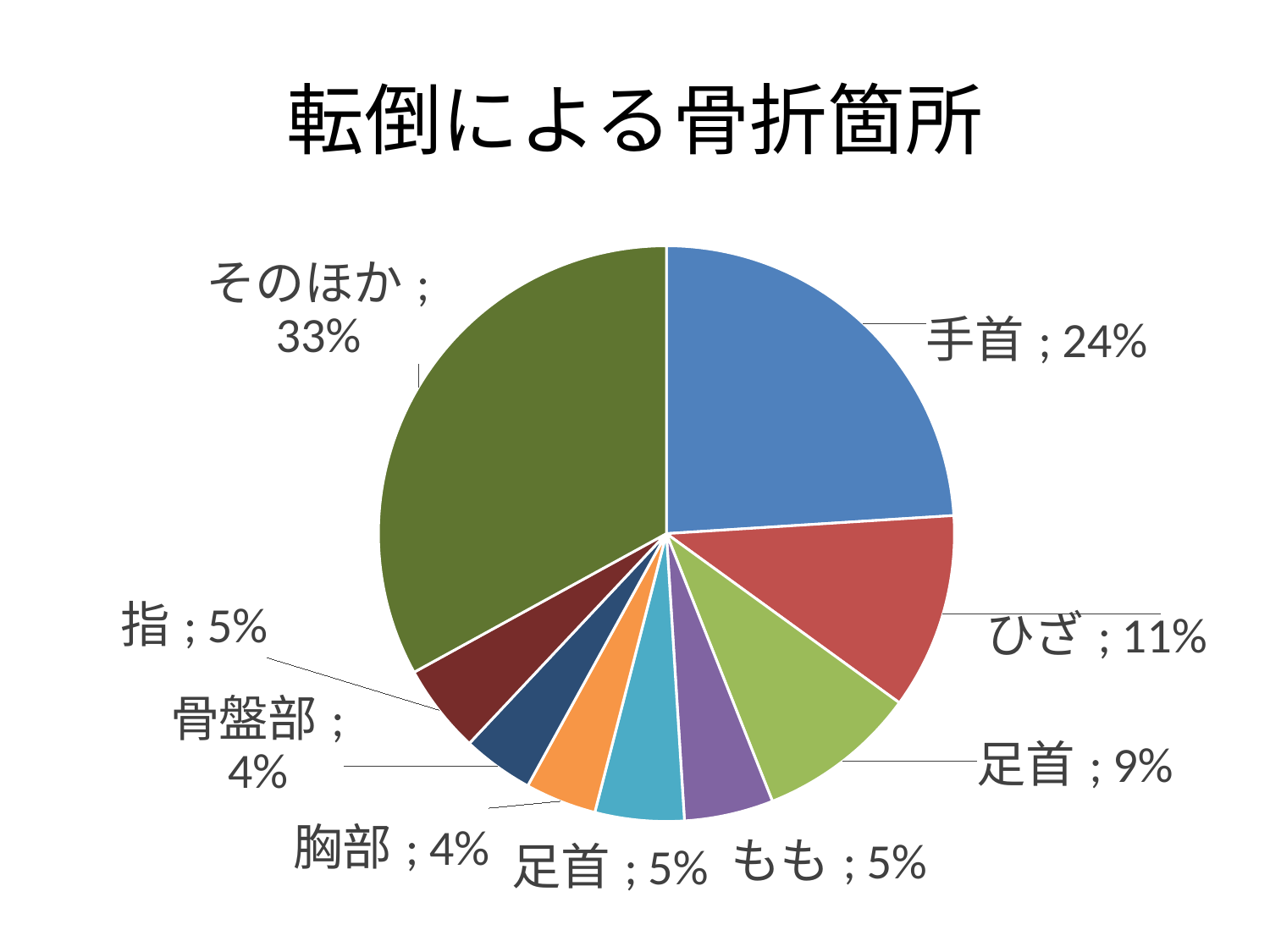
What percentage is shown for 骨盤部? 4% What percentage is shown for ひざ? 11% What percentage is shown for もも? 5% What percentage is shown for 指? 5% Which category has the largest slice of the pie? そのほか What percentage is shown for そのほか? 33% What is the title of the chart? 転倒による骨折箇所 What percentage is shown for 手首? 24% How many slices does the pie chart have? 9 What percentage is shown for 胸部? 4% What kind of chart is shown on the slide? pie chart What is the difference in percentage points between 手首 and ひざ? 13